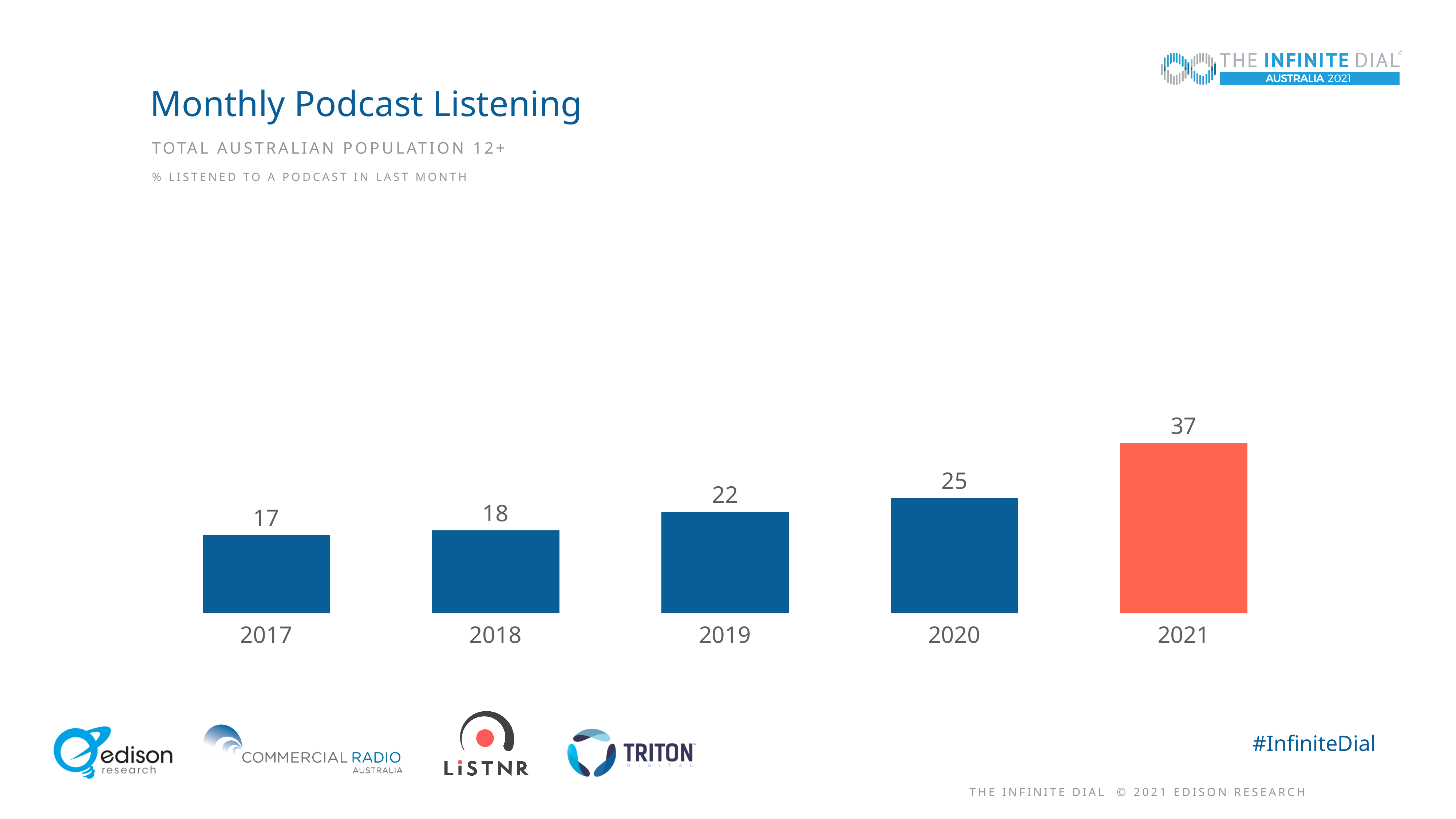
Which year has the highest value? 2021 What is the value for 2019? 22 What is the difference between the values for 2019 and 2018? 4 What is the title of the chart? Monthly Podcast Listening Which year has the lowest value? 2017 What is the value for 2017? 17 How many years are shown on the chart? 5 What kind of chart is shown on the slide? bar chart What is the difference between the values for 2021 and 2020? 12 Do the values rise or fall from 2017 to 2021? rise Which is larger, the value for 2020 or the value for 2018? 2020 What is the value for 2021? 37